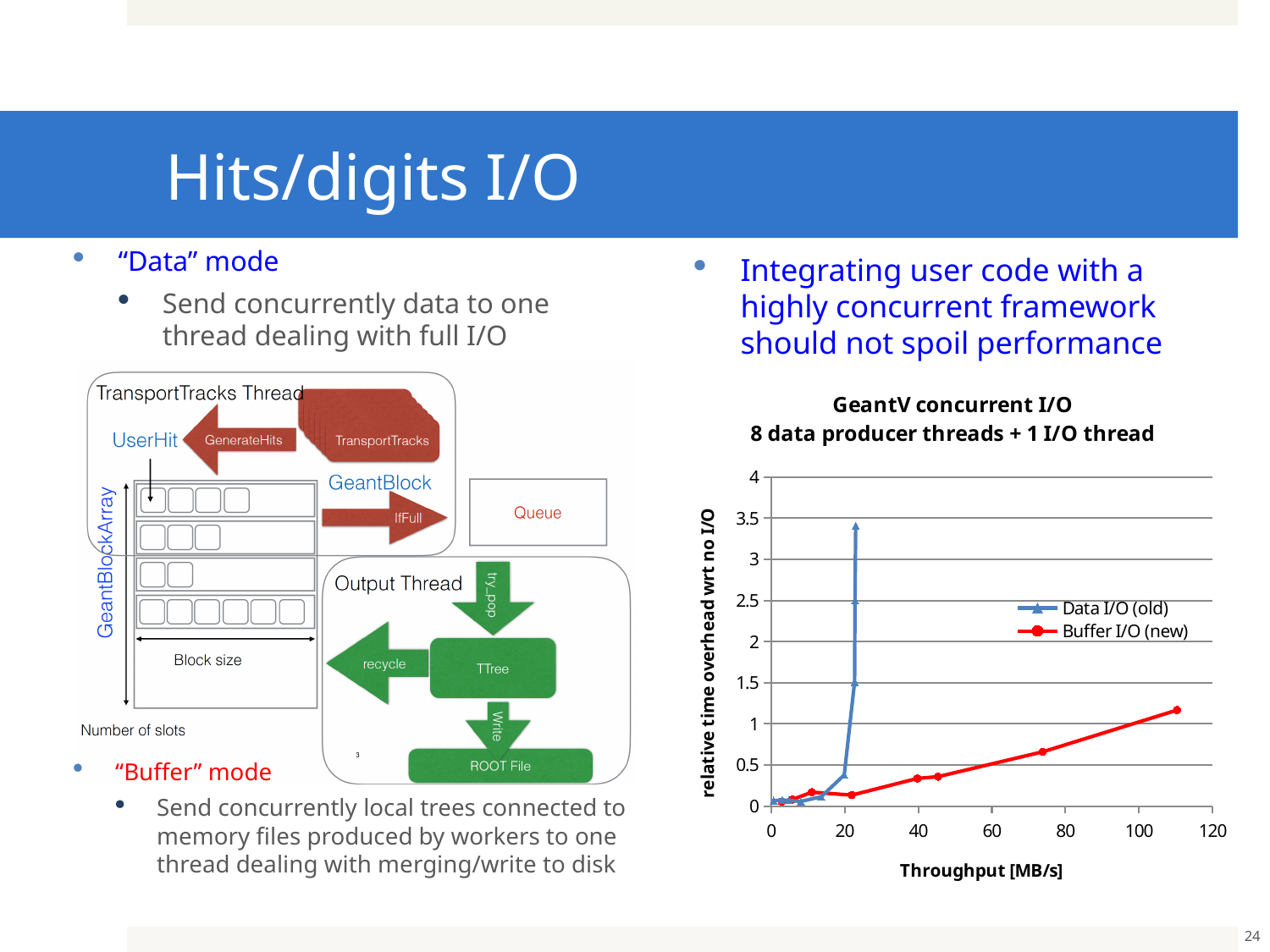
Which series has the lower overhead at a throughput of about 22 MB/s? Buffer I/O (new) What kind of chart is shown on the slide? line chart Is the highest value of the Data I/O (old) series greater or less than 3? greater What is the label of the x axis of the chart? Throughput [MB/s] Does the relative time overhead of the Buffer I/O (new) series rise or fall as throughput increases? rise How many series does the legend of the chart list? 2 Is the highest value of the Buffer I/O (new) series greater or less than 1.5? less What is the title of the chart? GeantV concurrent I/O 8 data producer threads + 1 I/O thread Which series reaches the highest relative time overhead in the chart? Data I/O (old) Which series reaches the higher throughput, Data I/O (old) or Buffer I/O (new)? Buffer I/O (new) Is the highest value of the Buffer I/O (new) series greater or less than 1? greater